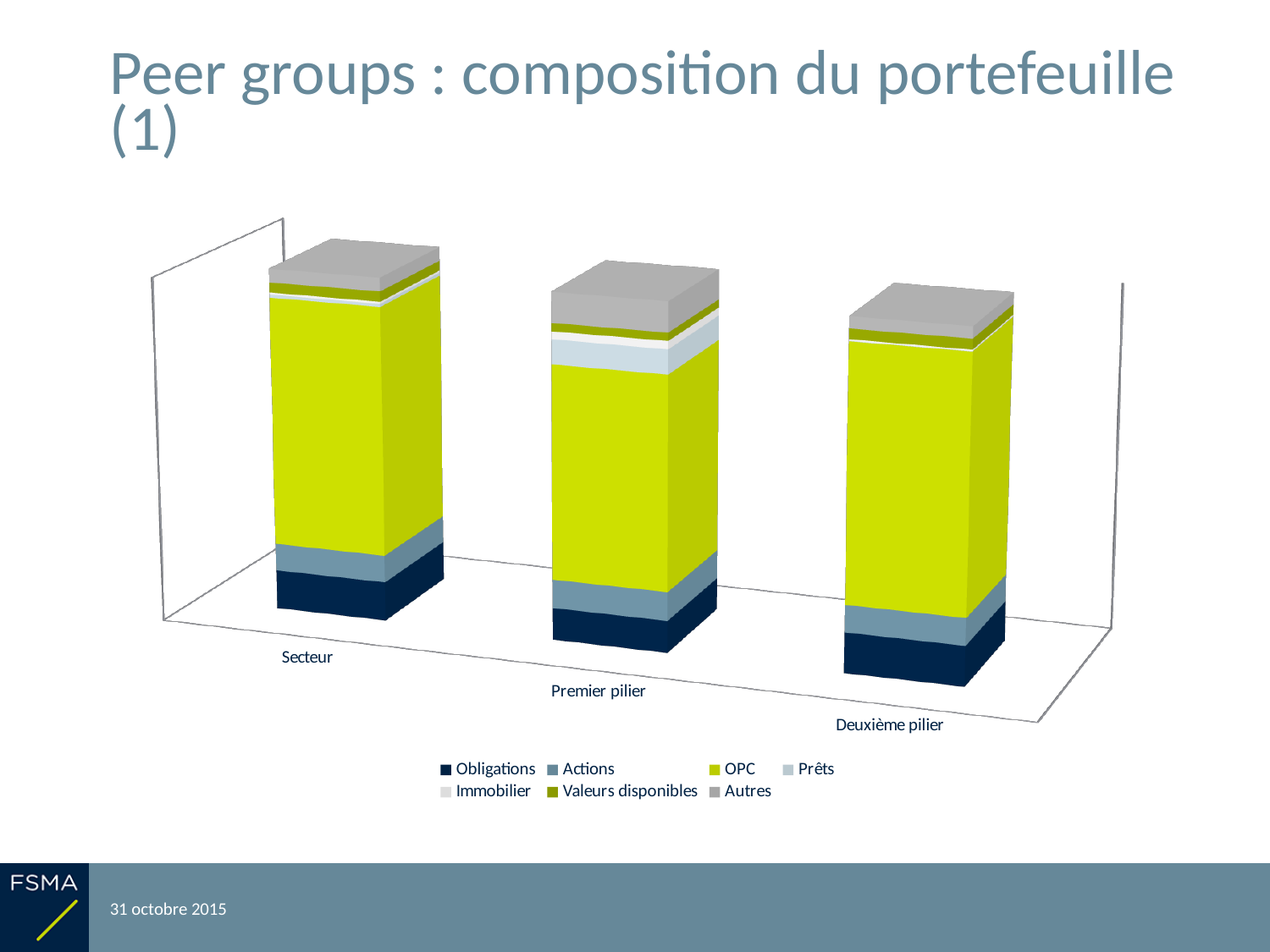
How many categories are shown along the x axis of the chart? 3 Which series occupies the largest portion of the Secteur bar? OPC Which series occupies the largest portion of the Premier pilier bar? OPC Which category is listed last along the x axis of the chart? Deuxième pilier How many series does the chart's legend list? 7 In which category is the Prêts segment the largest? Premier pilier What kind of chart is shown on the slide? Stacked bar chart Which series is listed first in the chart's legend? Obligations Which series occupies the largest portion of the Deuxième pilier bar? OPC